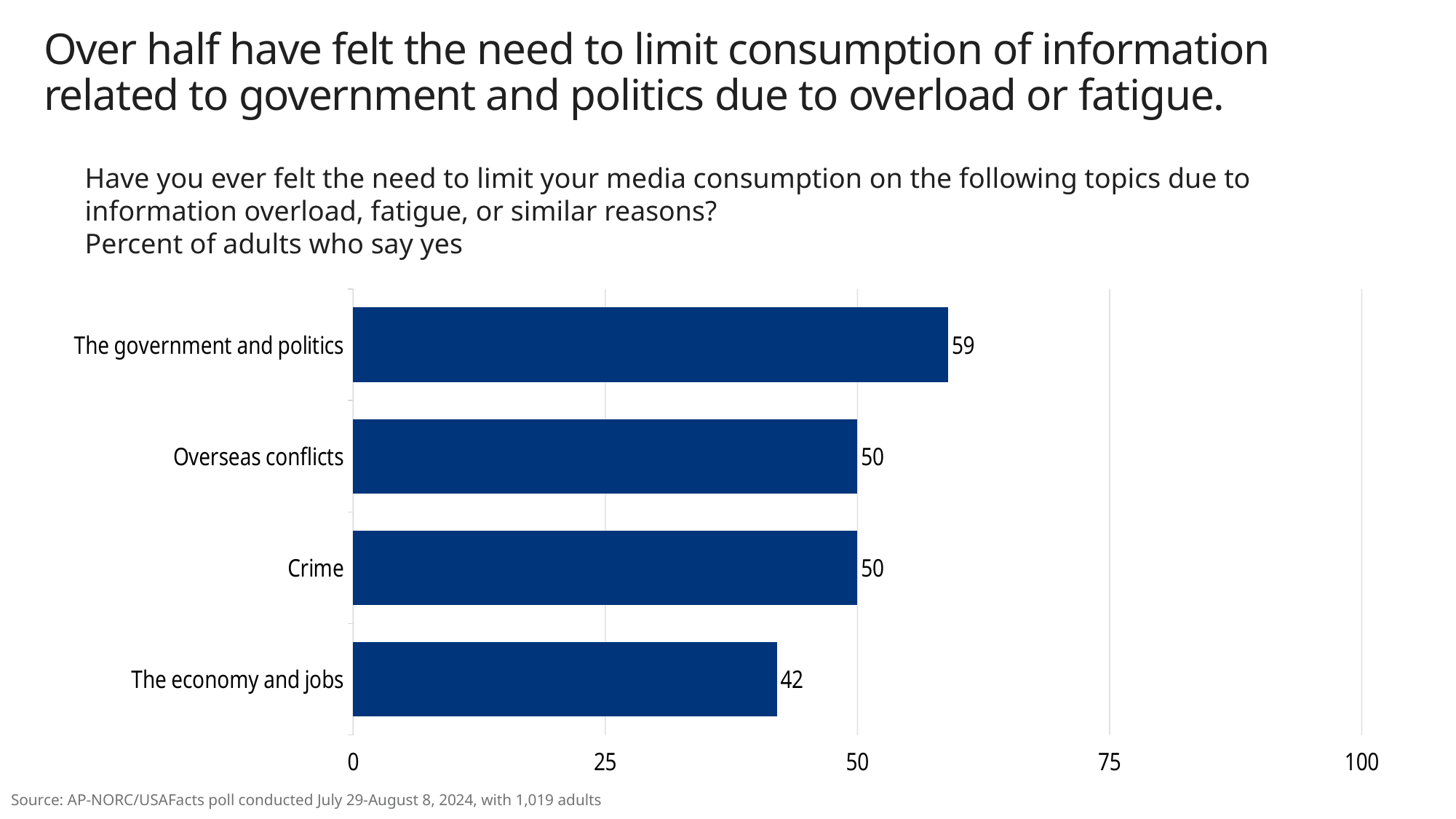
What kind of chart is shown on the slide? Bar chart Which topic has the highest percent of adults saying yes? The government and politics What is the highest value labeled on the horizontal axis? 100 Which topic has the lowest percent of adults saying yes? The economy and jobs How many topics are shown in the chart? 4 What is the value shown for Overseas conflicts? 50 What is the difference between the values for The government and politics and The economy and jobs? 17 What is the value shown for The economy and jobs? 42 Which is larger, the value for Crime or the value for The economy and jobs? Crime Is the value for The government and politics greater or less than 50? greater What percent of adults say they have felt the need to limit media consumption on the government and politics? 59 What is the difference between the values for Overseas conflicts and The economy and jobs? 8